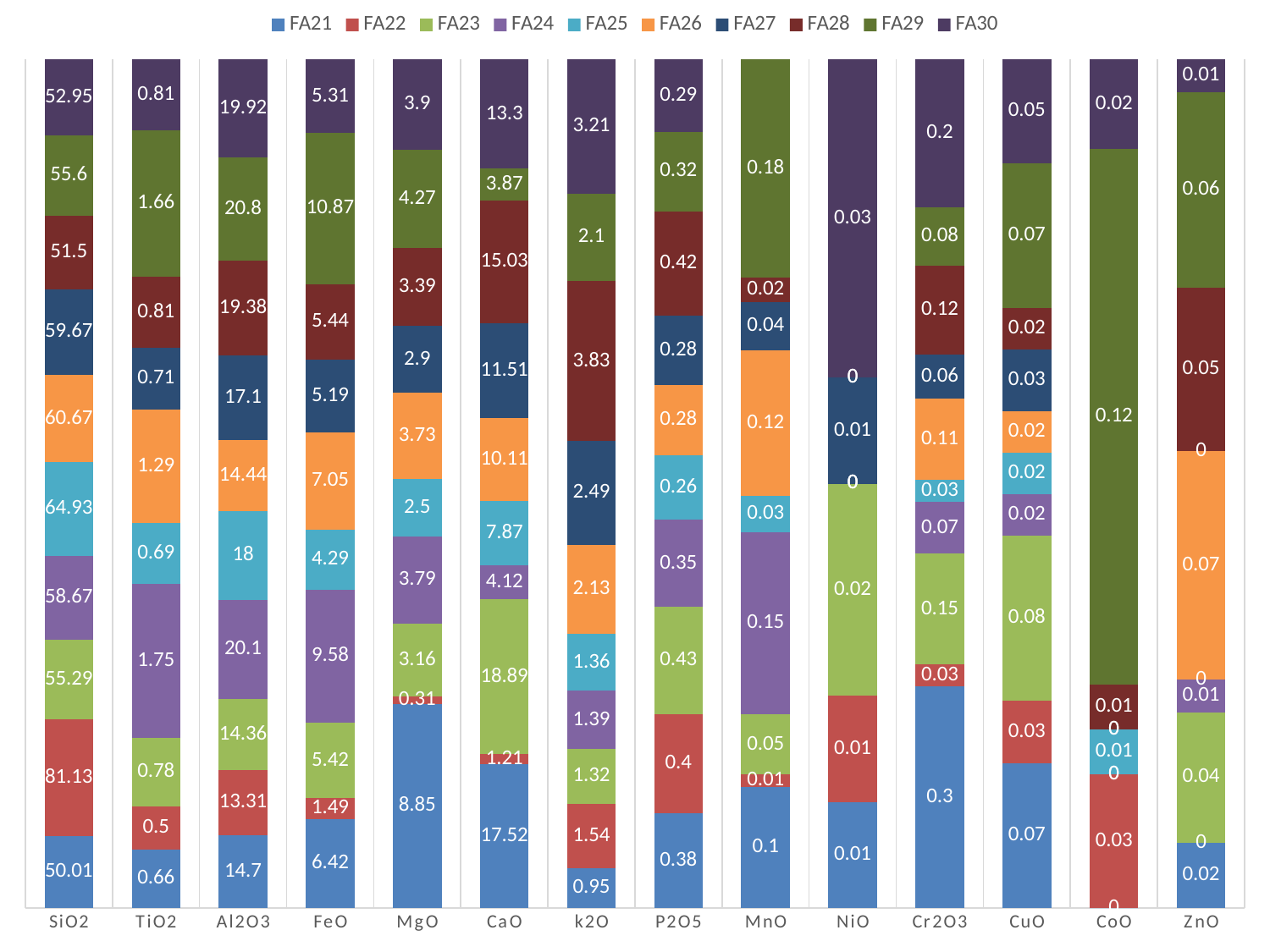
How many categories are shown on the x axis? 14 What is the difference between the FA22 and FA21 values for SiO2? 31.12 What is the value of FA22 for SiO2? 81.13 What is the value of FA28 for k2O? 3.83 What kind of chart is this? Stacked bar chart Which series has the lowest value in the CaO bar? FA22 What is the value of FA21 for SiO2? 50.01 For FeO, which is larger: the FA29 value or the FA24 value? FA29 What is the value of FA29 for MgO? 4.27 How many series does the legend list? 10 Which series has the highest value in the SiO2 bar? FA22 What is the value of FA30 for Al2O3? 19.92